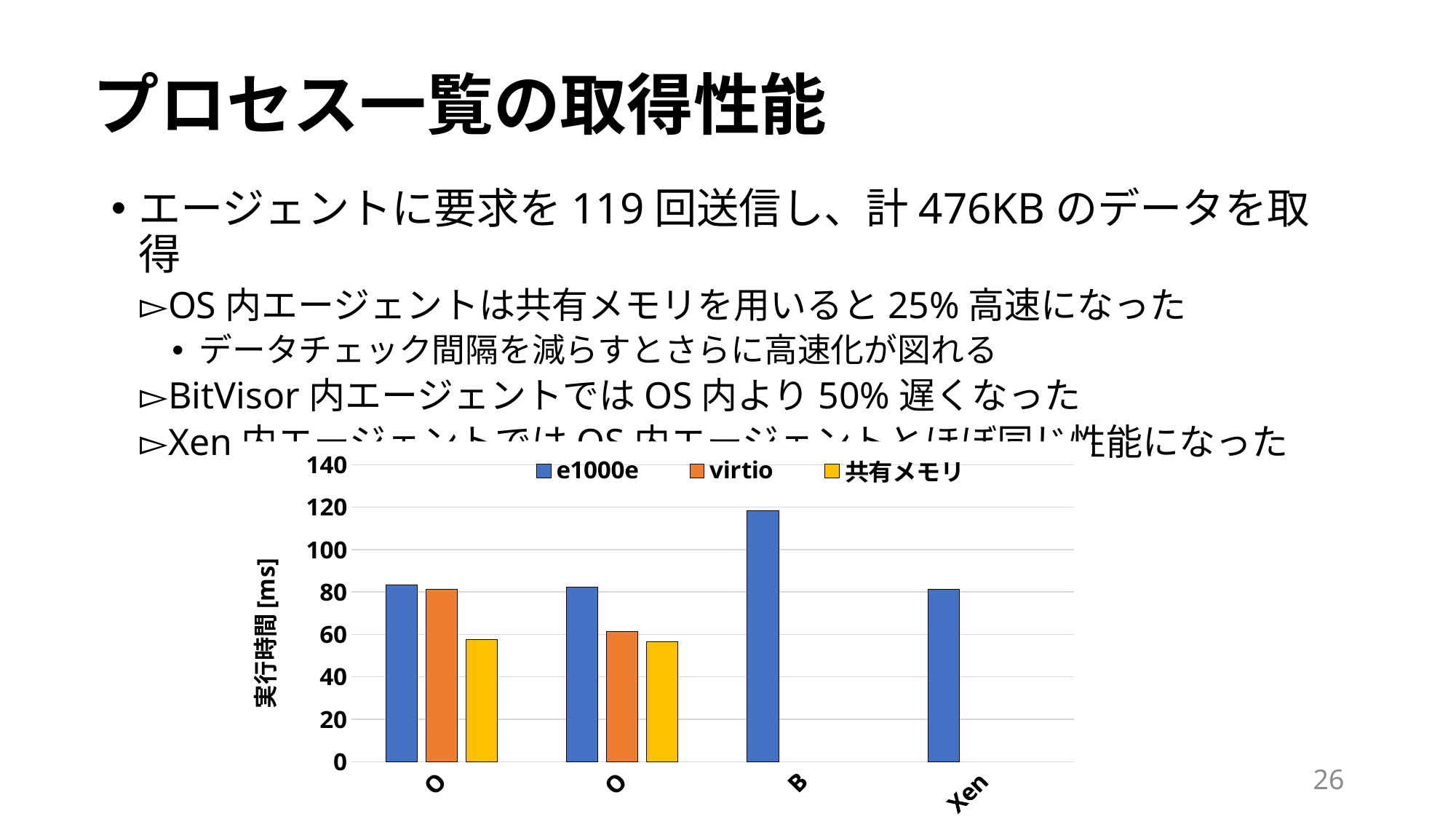
How many bars are plotted in total on the chart? 8 In the leftmost group of bars, which is larger, e1000e or 共有メモリ? e1000e How many series does the chart legend list? 3 Is the e1000e value for Xen greater or less than 100? less What is the label of the chart's vertical axis? 実行時間 [ms] Is the tallest bar on the chart greater or less than 100? greater What kind of chart is shown on the slide? bar chart Is the 共有メモリ value in the leftmost group greater or less than 80? less Which series is the only one plotted for the Xen category? e1000e How many categories are shown along the x axis of the chart? 4 What are the three series named in the chart legend? e1000e, virtio, 共有メモリ